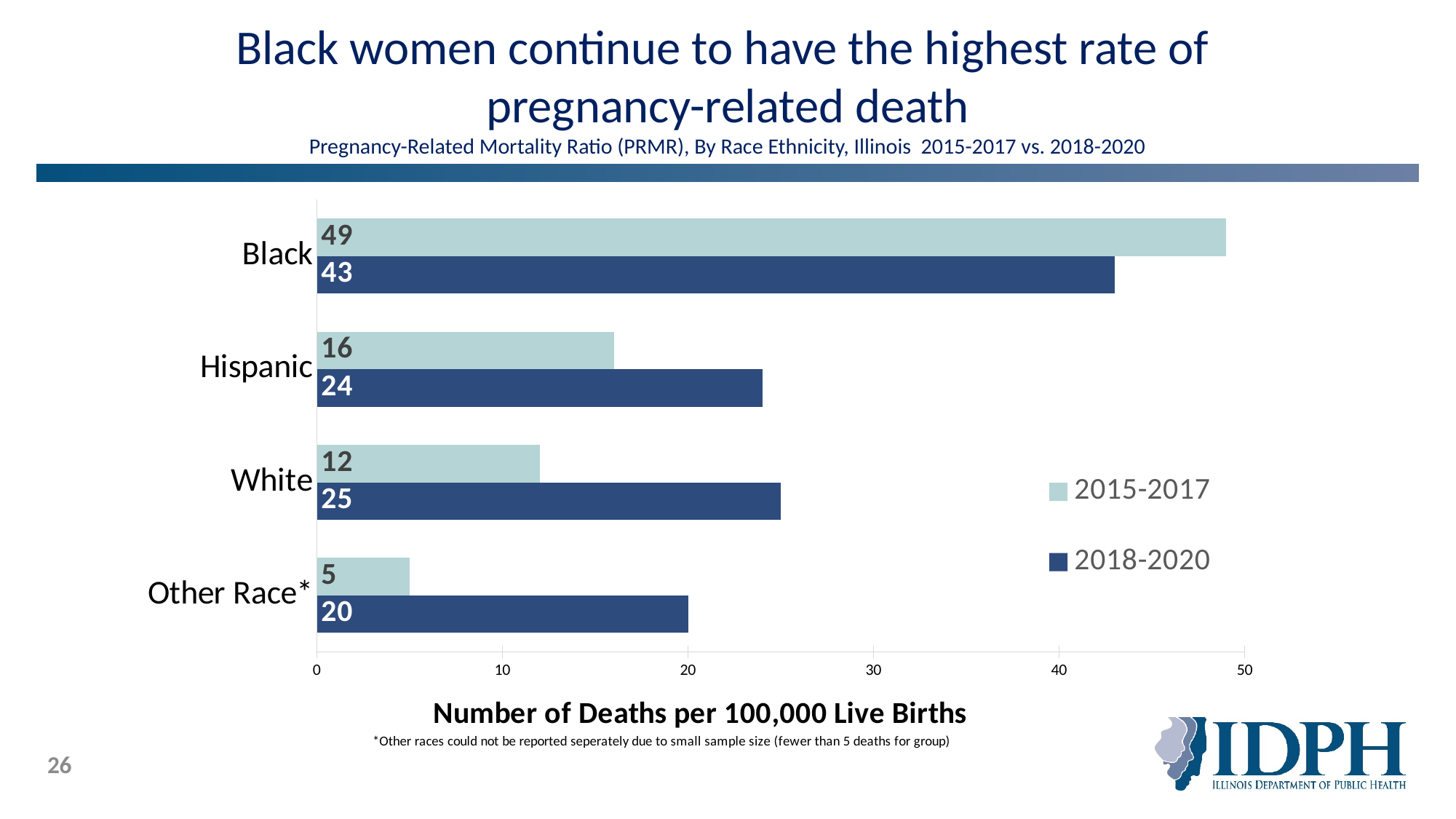
Is the value for Black women in 2018-2020 greater or less than 40? greater What is the value for White women in 2015-2017? 12 What is the pregnancy-related mortality ratio for Hispanic women in 2018-2020? 24 Which race/ethnicity group has the highest value in 2018-2020? Black What is the difference between the Black values for 2015-2017 and 2018-2020? 6 Which race/ethnicity group has the lowest value in 2015-2017? Other Race* What is the label of the x axis? Number of Deaths per 100,000 Live Births How many series does the legend list? 2 What kind of chart is shown on the slide? Bar chart What is the pregnancy-related mortality ratio for Black women in 2015-2017? 49 Which is larger for White women: the 2015-2017 value or the 2018-2020 value? 2018-2020 How many race/ethnicity categories are shown on the chart? 4